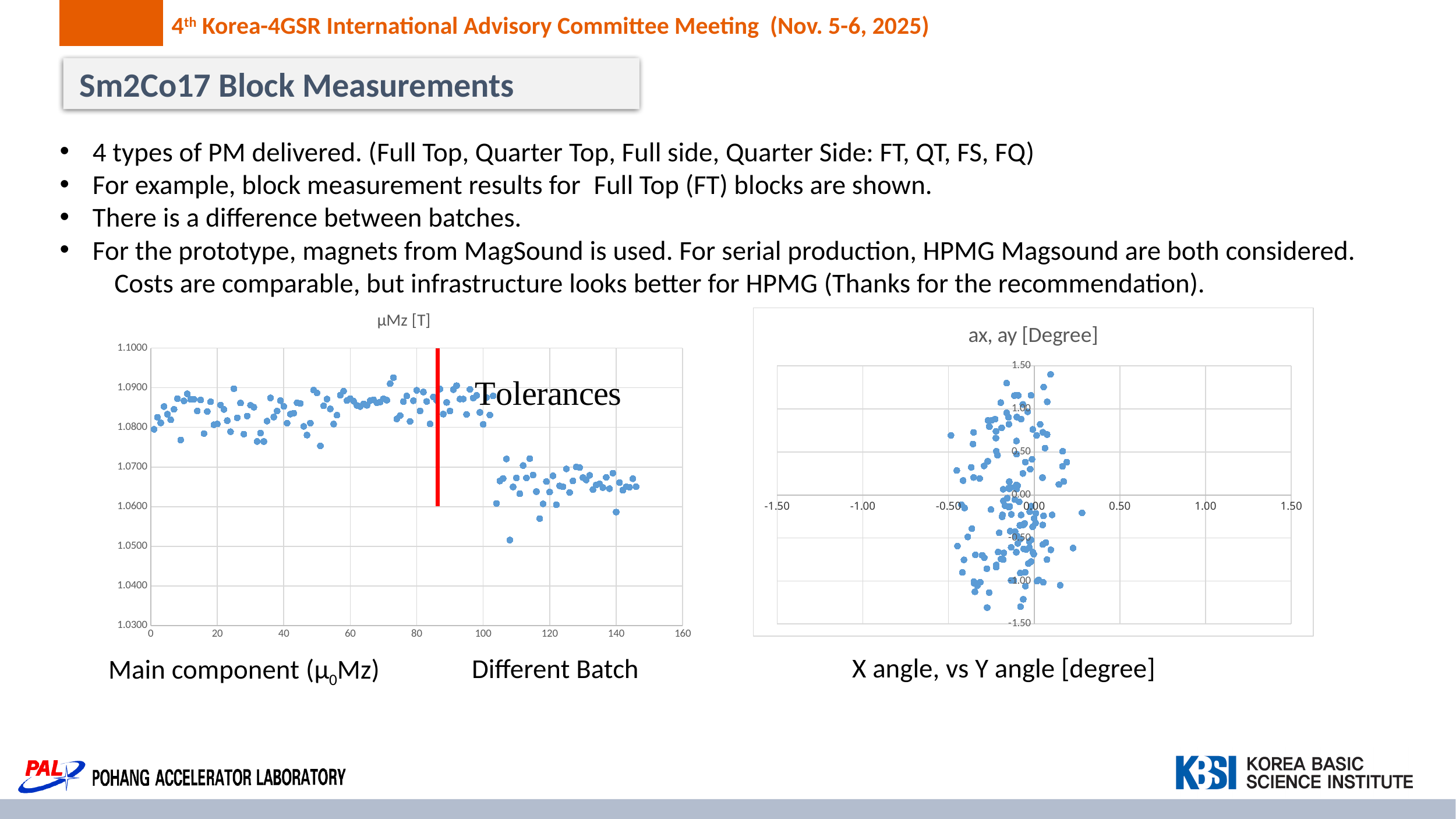
What kind of chart is the left chart titled "μMz [T]"? scatter chart In the left chart "μMz [T]", what is the lowest value shown on the vertical axis? 1.0300 In the right chart "ax, ay [Degree]", what are the minimum and maximum values shown on the horizontal axis? -1.50 and 1.50 In the left chart "μMz [T]", what is the highest value shown on the vertical axis? 1.1000 What is the title of the left chart? μMz [T] In the right chart "ax, ay [Degree]", are any points plotted with an x value greater than 1.00? No What is the title of the right chart? ax, ay [Degree] In the left chart "μMz [T]", what is the maximum value shown on the horizontal axis? 160 What kind of chart is the right chart titled "ax, ay [Degree]"? scatter chart In the left chart "μMz [T]", are the points plotted between x = 0 and x = 80 greater or less than 1.0700? greater In the left chart "μMz [T]", do the plotted values rise or fall when moving from the first group of points (x below 100) to the second group (x above 100)? fall